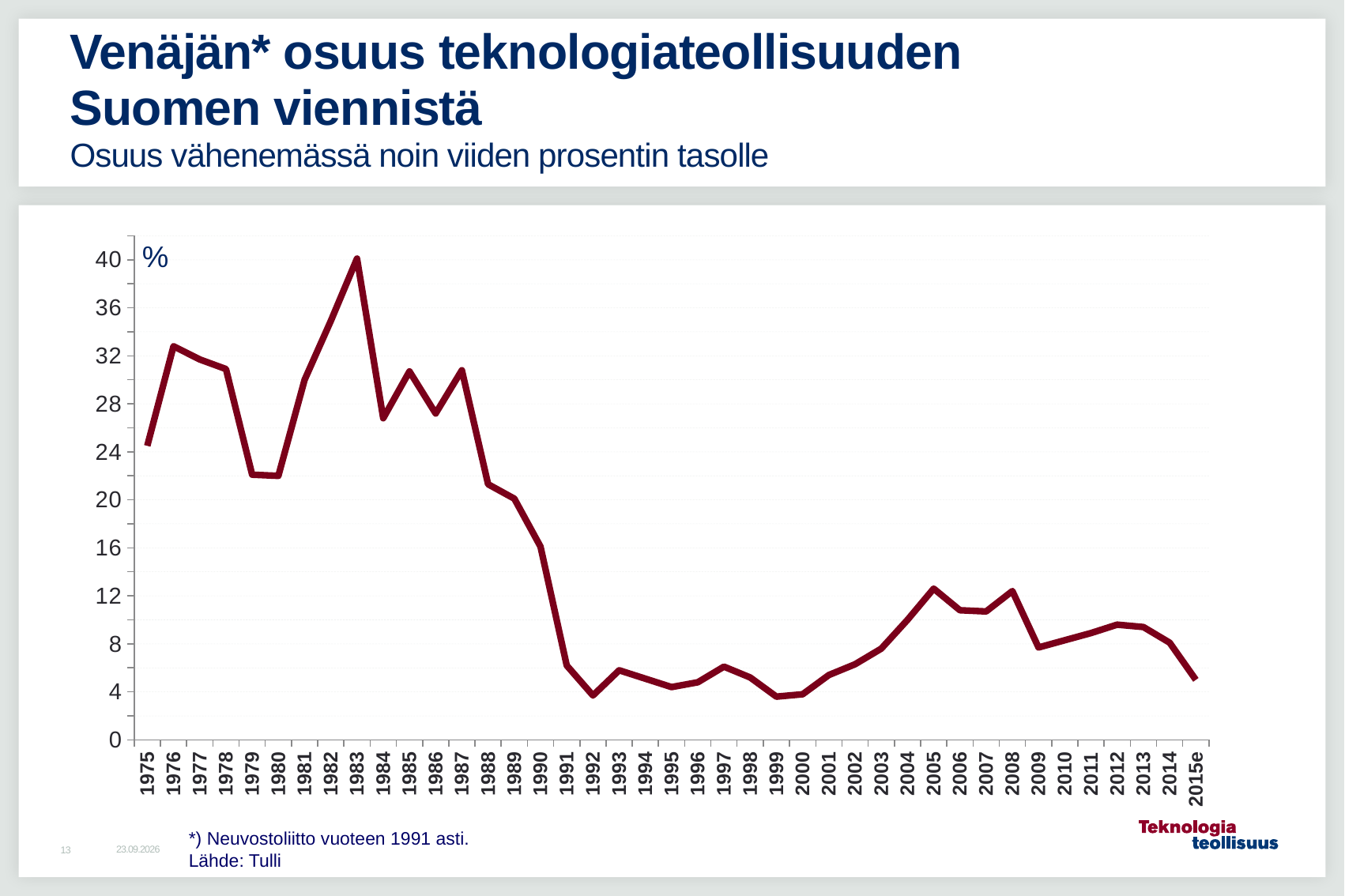
Which is larger, the value for 1990 or the value for 1991? 1990 Is the value for 1983 greater or less than 36? greater What unit is shown on the vertical axis of the chart? % Is the value for 2005 greater or less than 8? greater What kind of chart is shown on the slide? line chart Is the value for 1991 greater or less than 8? less Does the value rise or fall between 1983 and 1992? fall Which is larger, the value for 1976 or the value for 1979? 1976 Which year has the highest value on the chart? 1983 Does the value rise or fall between 2000 and 2005? rise